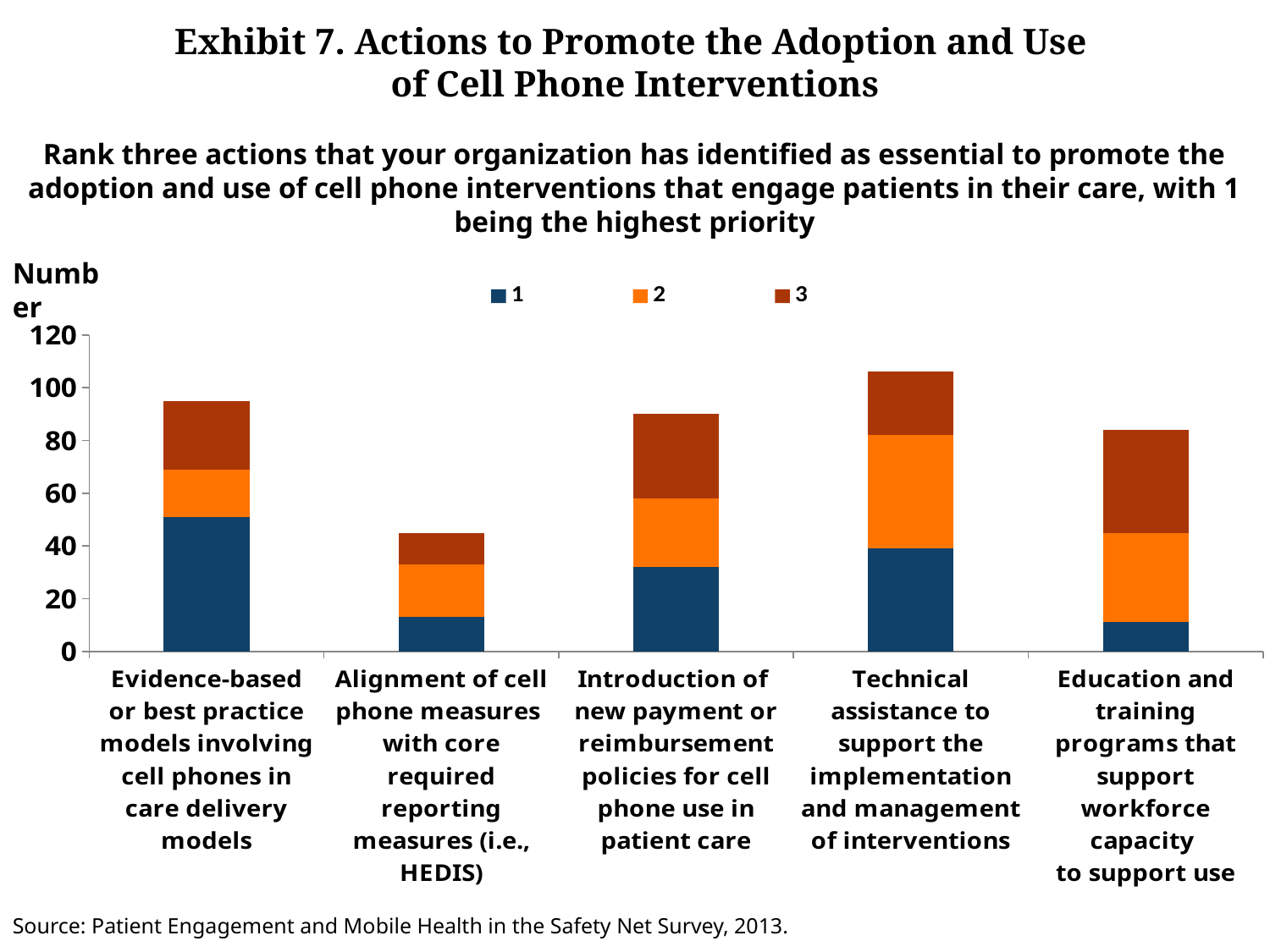
Is the total stacked value for "Technical assistance to support the implementation and management of interventions" greater or less than 100? greater Is the rank-1 (series "1") value for "Evidence-based or best practice models involving cell phones in care delivery models" greater or less than 40? greater How many actions (categories) are shown on the x axis? 5 How many series does the legend list? 3 What are the three entries listed in the legend? 1, 2, 3 What kind of chart is shown on the slide? Stacked bar chart Is the total stacked value for "Alignment of cell phone measures with core required reporting measures (i.e., HEDIS)" greater or less than 60? less Which action has the largest number of rank-1 (series "1") responses? Evidence-based or best practice models involving cell phones in care delivery models Which action has the tallest stacked bar overall? Technical assistance to support the implementation and management of interventions Which has the larger total stacked bar: "Technical assistance to support the implementation and management of interventions" or "Education and training programs that support workforce capacity to support use"? Technical assistance to support the implementation and management of interventions Which action has the shortest stacked bar overall? Alignment of cell phone measures with core required reporting measures (i.e., HEDIS) What is the label on the vertical axis? Number